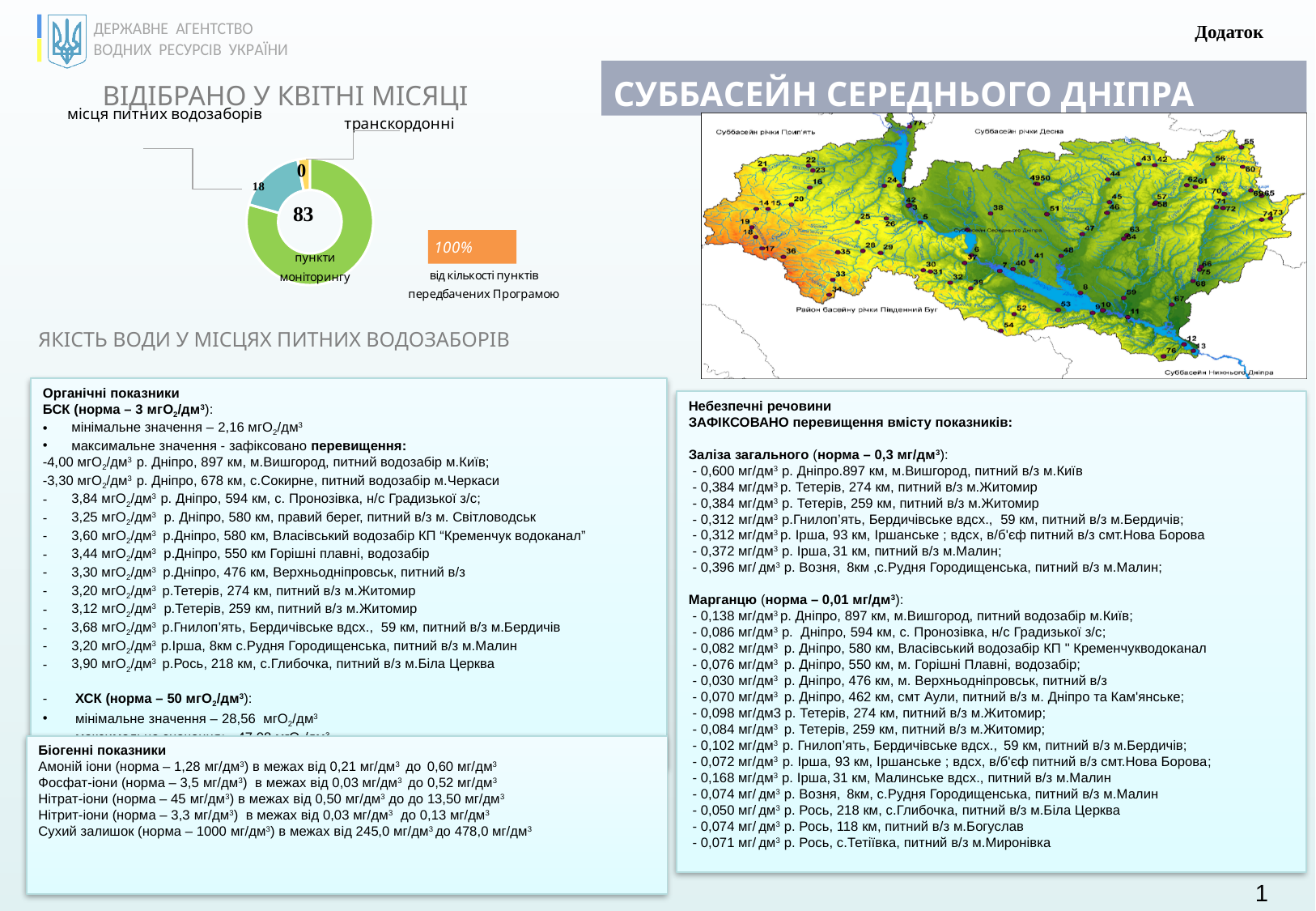
In the doughnut chart, which is larger: "місця питних водозаборів" or "транскордонні"? місця питних водозаборів Which category has the largest value in the doughnut chart? пункти моніторингу What percentage is shown in the orange box next to the doughnut chart? 100% What type of chart is shown under the heading "ВІДІБРАНО У КВІТНІ МІСЯЦІ"? Doughnut (pie) chart In the doughnut chart, what is the difference between the values for "пункти моніторингу" and "місця питних водозаборів"? 65 What is the title above the doughnut chart? ВІДІБРАНО У КВІТНІ МІСЯЦІ In the doughnut chart, what is the value for "пункти моніторингу"? 83 In the doughnut chart, what is the value for "місця питних водозаборів"? 18 Which category has the smallest value in the doughnut chart? транскордонні In the doughnut chart, what is the value for "транскордонні"? 0 What is the total of all values shown in the doughnut chart? 101 How many categories are shown in the doughnut chart? 3